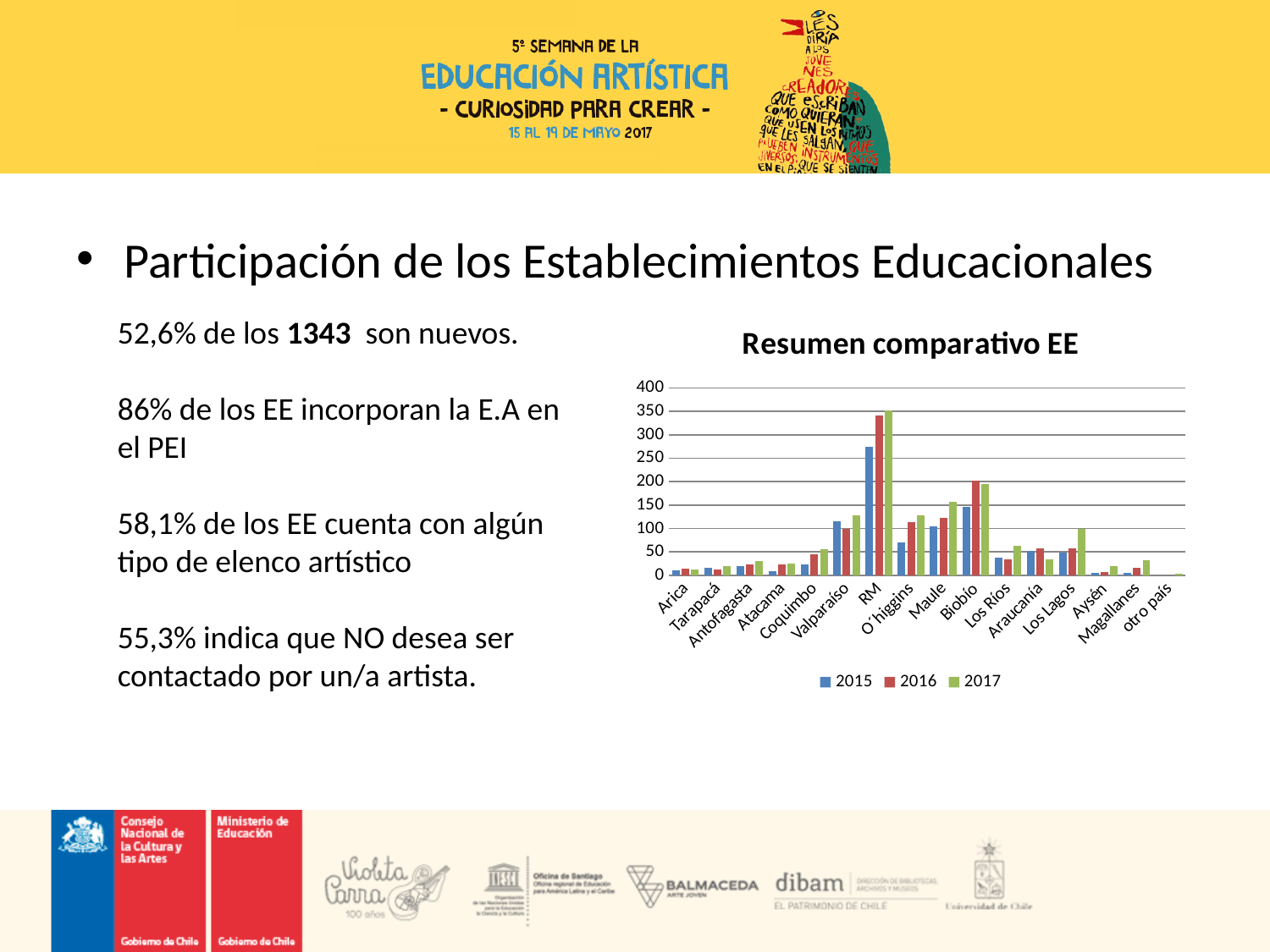
What type of chart is shown under the title 'Resumen comparativo EE'? bar chart Is the 2017 value for Arica greater or less than 50? less Is the 2015 value for Valparaíso greater or less than 100? greater How many categories are shown on the x axis of the 'Resumen comparativo EE' chart? 16 Is the 2015 value for RM greater or less than 250? greater How many series does the legend of the 'Resumen comparativo EE' chart list? 3 Which category has the highest bars in the 'Resumen comparativo EE' chart? RM Which has a larger 2017 value, RM or Biobío? RM Which years are listed in the legend of the 'Resumen comparativo EE' chart? 2015, 2016, 2017 Which has a larger 2017 value, Valparaíso or Coquimbo? Valparaíso Which category has the lowest values in the 'Resumen comparativo EE' chart? otro país